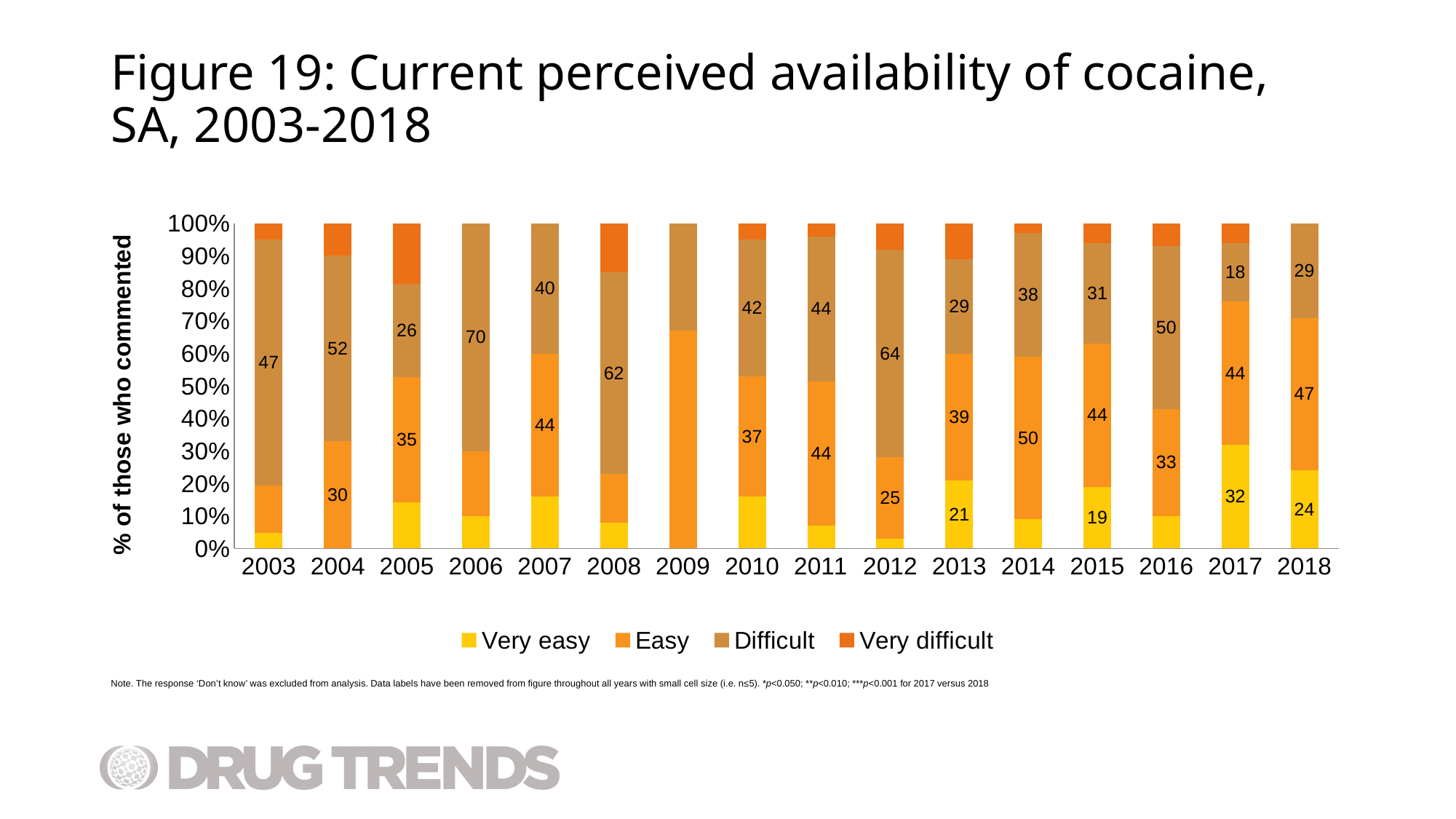
What is the value for Difficult in 2018? 29 Among the labelled Difficult values, which year has the lowest? 2017 What kind of chart is shown on the slide? Stacked bar chart What is the difference between the Easy value in 2018 and the Easy value in 2017? 3 What is the value for Easy in 2014? 50 Which year has the larger Easy value, 2012 or 2013? 2013 Is the Easy segment for 2009 greater or less than 60%? greater What is the value for Very easy in 2017? 32 How many years are shown on the x axis? 16 Among the labelled Difficult values, which year has the highest? 2006 How many series does the legend list? 4 What is the value for Difficult in 2006? 70